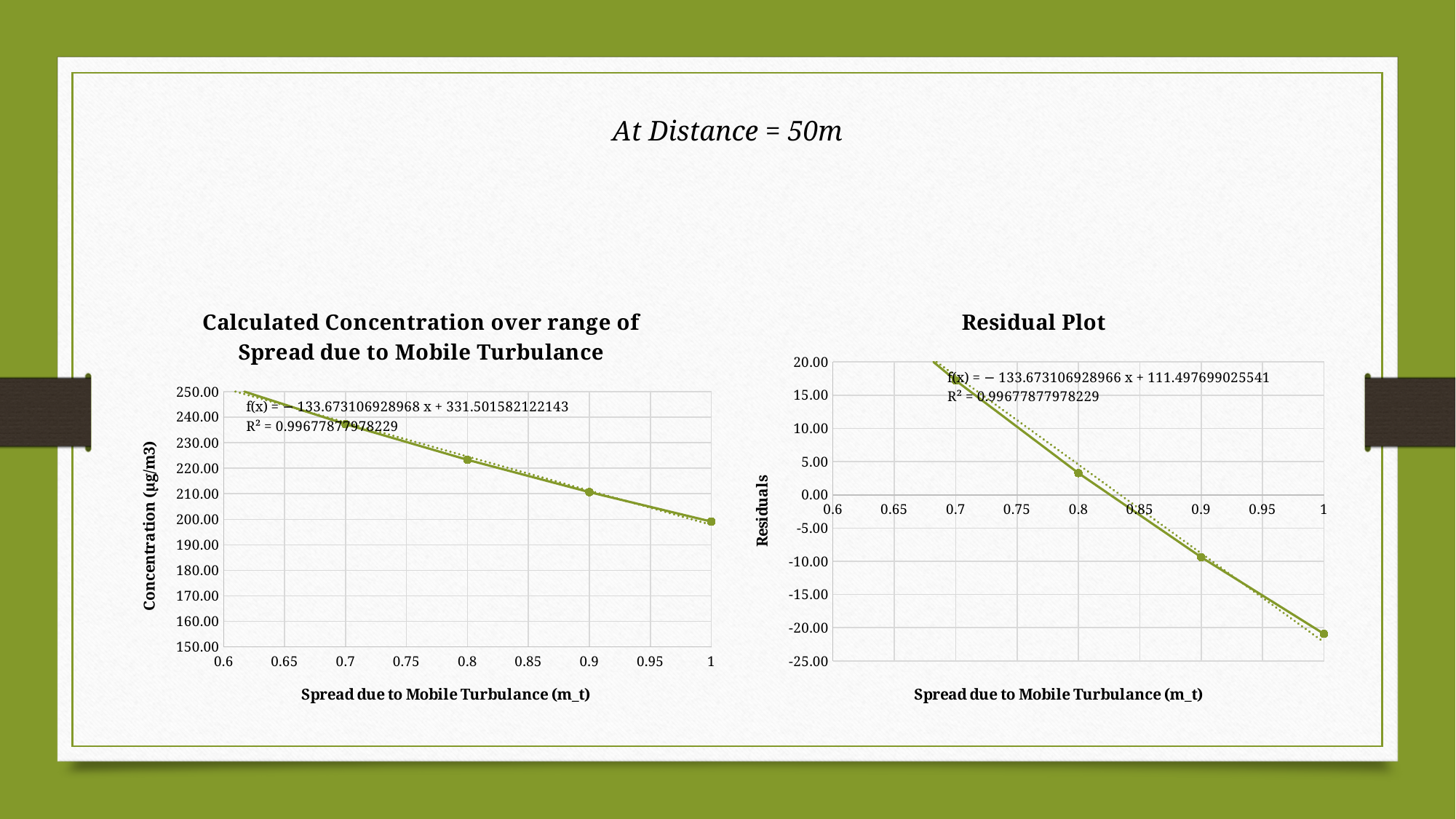
On the 'Calculated Concentration over range of Spread due to Mobile Turbulance' chart, do the values rise or fall as the spread increases from 0.8 to 1? Fall What is the y-axis label of the 'Calculated Concentration over range of Spread due to Mobile Turbulance' chart? Concentration (µg/m3) What kind of chart is the 'Calculated Concentration over range of Spread due to Mobile Turbulance' chart? Line chart What R² value is shown on the 'Residual Plot' chart? 0.99677877978229 On the 'Calculated Concentration over range of Spread due to Mobile Turbulance' chart, is the concentration at spread 0.8 greater or less than 220.00? greater On the 'Residual Plot' chart, which spread value has the lowest residual? 1 On the 'Residual Plot' chart, is the residual at spread 0.8 greater or less than 0.00? greater